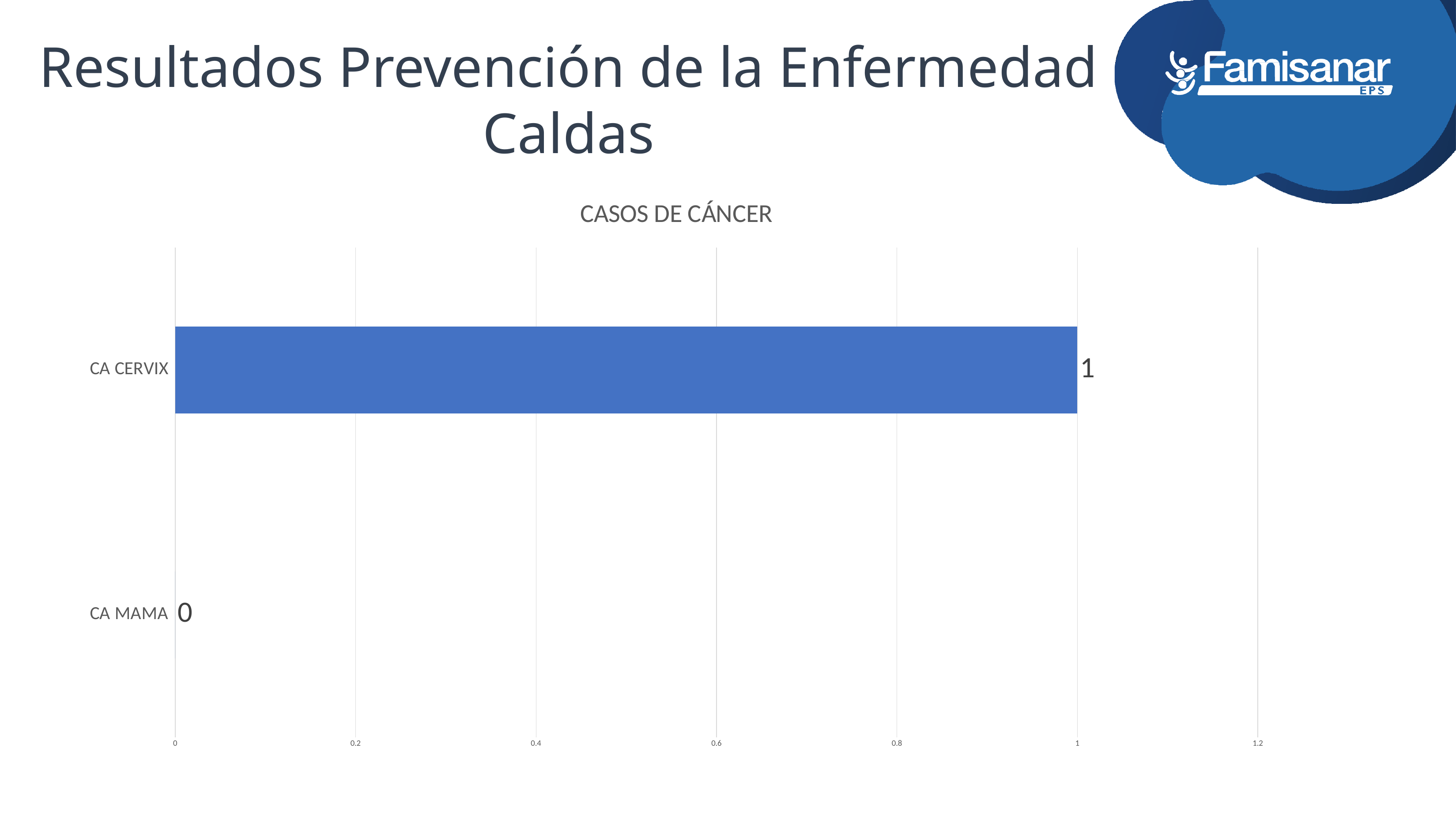
What kind of chart is shown on the slide? bar chart What is the value for CA CERVIX? 1 What is the highest value shown on the horizontal axis? 1.2 What is the value for CA MAMA? 0 How many categories are shown in the chart? 2 What is the title of the chart? CASOS DE CÁNCER Is the value for CA CERVIX greater or less than 0.6? greater Which is larger, the value for CA CERVIX or the value for CA MAMA? CA CERVIX What is the difference between the values for CA CERVIX and CA MAMA? 1 Which category has the highest value? CA CERVIX Which category has the lowest value? CA MAMA